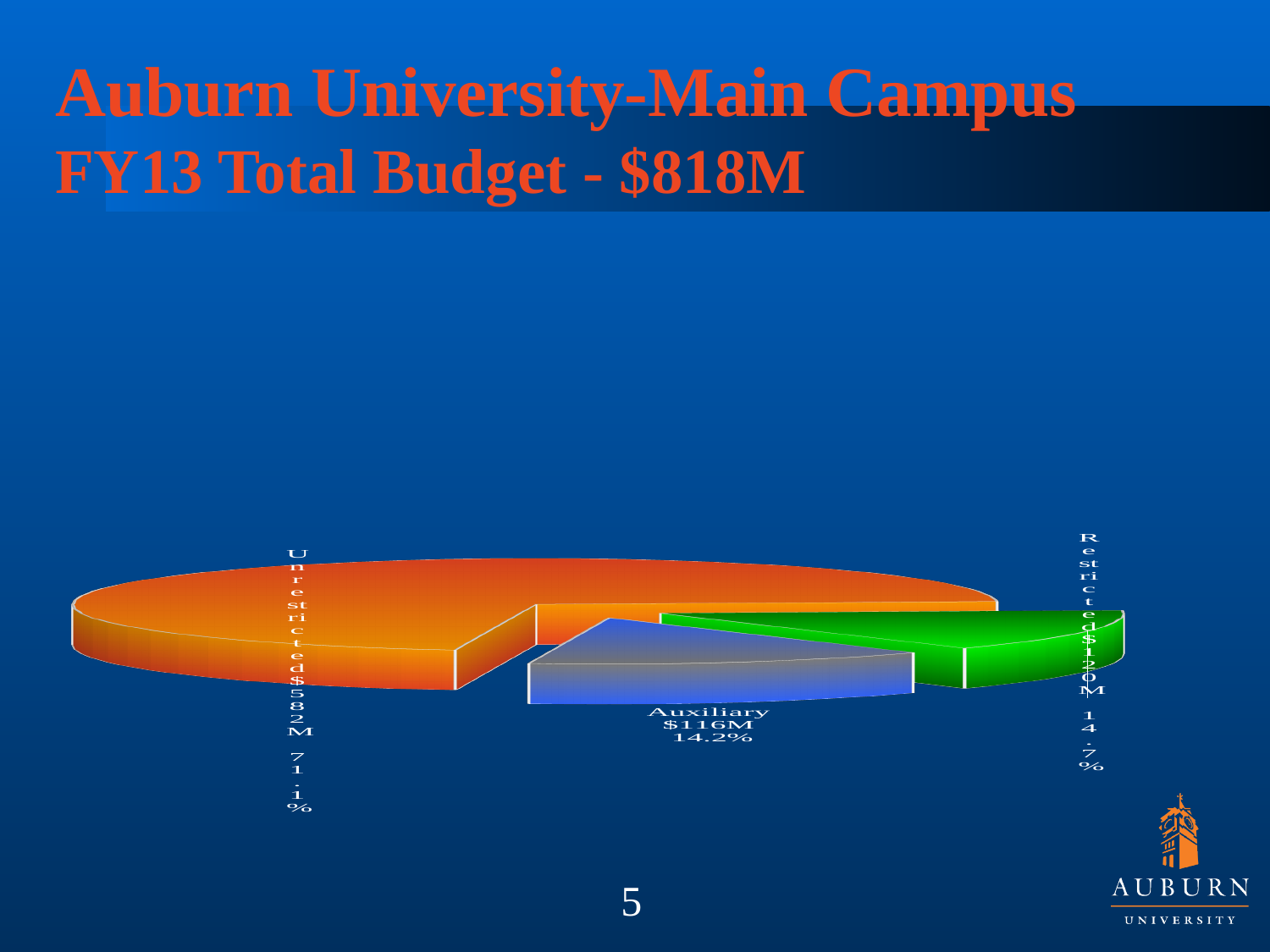
How many slices does the pie chart have? 3 What share of the pie does the Unrestricted slice represent? 71.1% What share of the pie does the Restricted slice represent? 14.7% What is the dollar value of the Unrestricted slice? $582M What is the dollar value of the Auxiliary slice? $116M What kind of chart is shown on the slide? pie chart What is the dollar value of the Restricted slice? $120M Which slice of the pie chart is the largest? Unrestricted What total budget is stated in the slide title? $818M What is the difference in dollars between the Unrestricted and Restricted slices? $462M What share of the pie does the Auxiliary slice represent? 14.2% Which slice of the pie chart is the smallest? Auxiliary